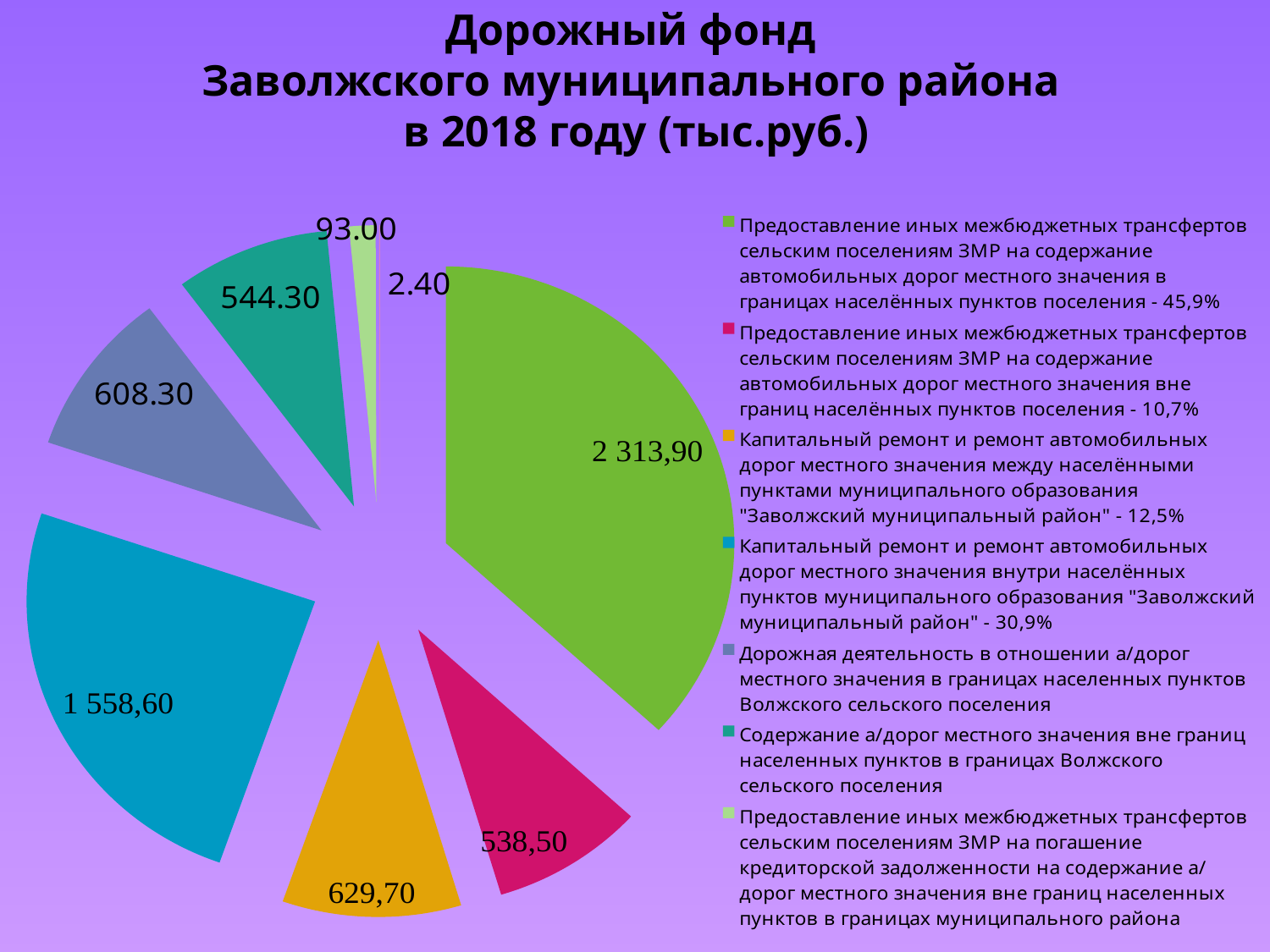
Which is larger: the orange slice (629,70) or the magenta slice (538,50)? the orange slice (629,70) What type of chart is shown on the slide? pie chart What is the value of the smallest slice in the pie chart? 2.40 What is the difference between the largest slice (2 313,90) and the slice valued 1 558,60? 755,30 How many entries does the legend list? 7 What is the value of the slice for "Дорожная деятельность в отношении а/дорог местного значения в границах населенных пунктов Волжского сельского поселения"? 608.30 How many slices does the pie chart have? 8 What is the value of the largest slice in the pie chart? 2 313,90 What is the value of the slice for "Капитальный ремонт и ремонт автомобильных дорог местного значения внутри населённых пунктов муниципального образования "Заволжский муниципальный район""? 1 558,60 According to the legend, what share of the road fund goes to "Предоставление иных межбюджетных трансфертов сельским поселениям ЗМР на содержание автомобильных дорог местного значения в границах населённых пунктов поселения"? 45,9% What is the value of the slice for "Предоставление иных межбюджетных трансфертов сельским поселениям ЗМР на погашение кредиторской задолженности"? 93.00 What is the value of the slice for "Содержание а/дорог местного значения вне границ населенных пунктов в границах Волжского сельского поселения"? 544.30